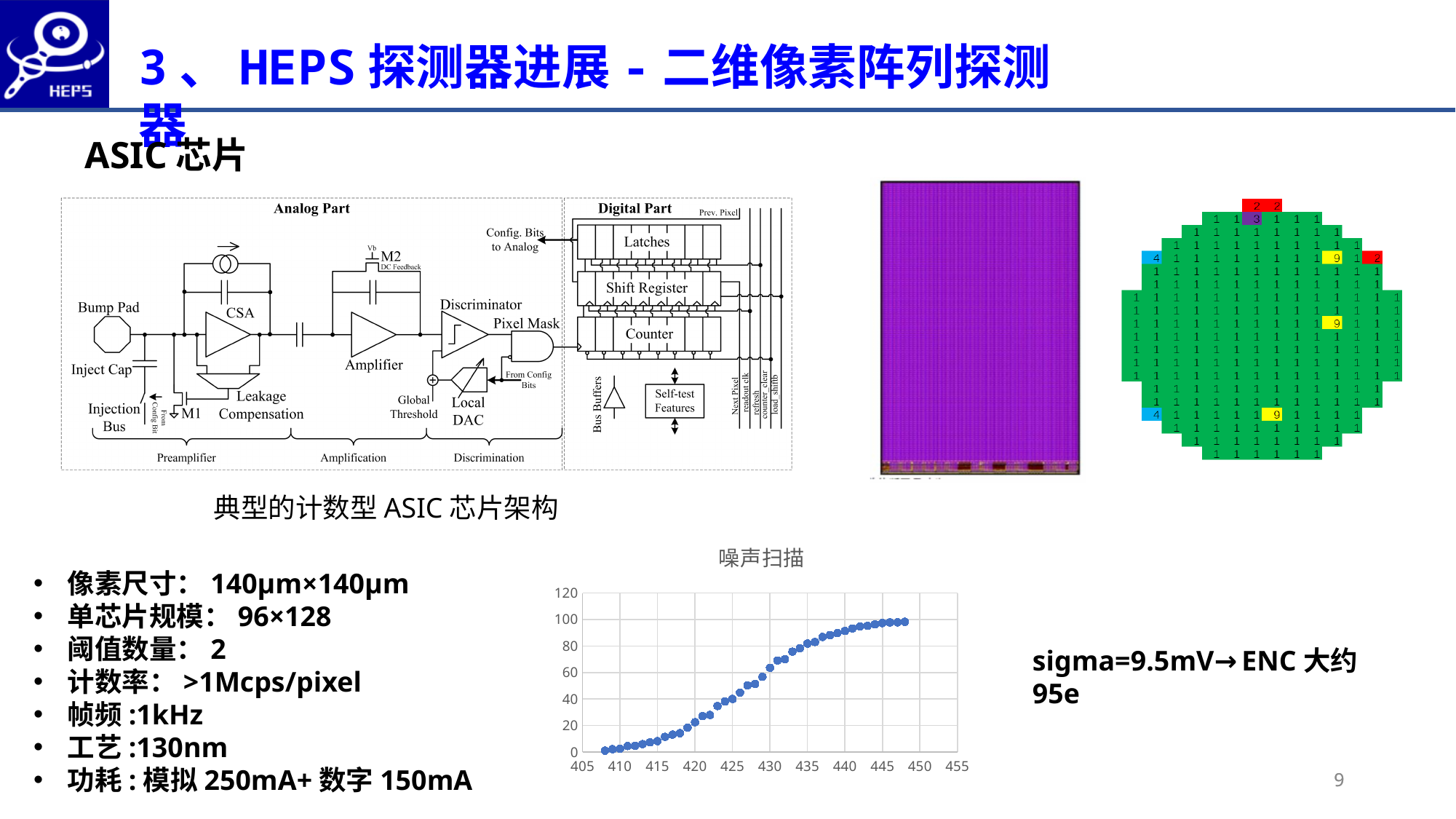
What is the title of the scatter chart on the slide? 噪声扫描 What is the highest tick value shown on the y-axis of the "噪声扫描" chart? 120 In the "噪声扫描" chart, is the value at x = 415 greater or less than 20? less In the "噪声扫描" chart, is the value at x = 430 greater or less than 60? greater In the "噪声扫描" chart, is the value at x = 445 greater or less than 80? greater In the "噪声扫描" chart, which is larger: the value at x = 420 or the value at x = 440? the value at x = 440 In the "噪声扫描" chart, do the values rise or fall as the x-axis value increases from 405 to 450? rise What kind of chart is the "噪声扫描" chart? scatter chart